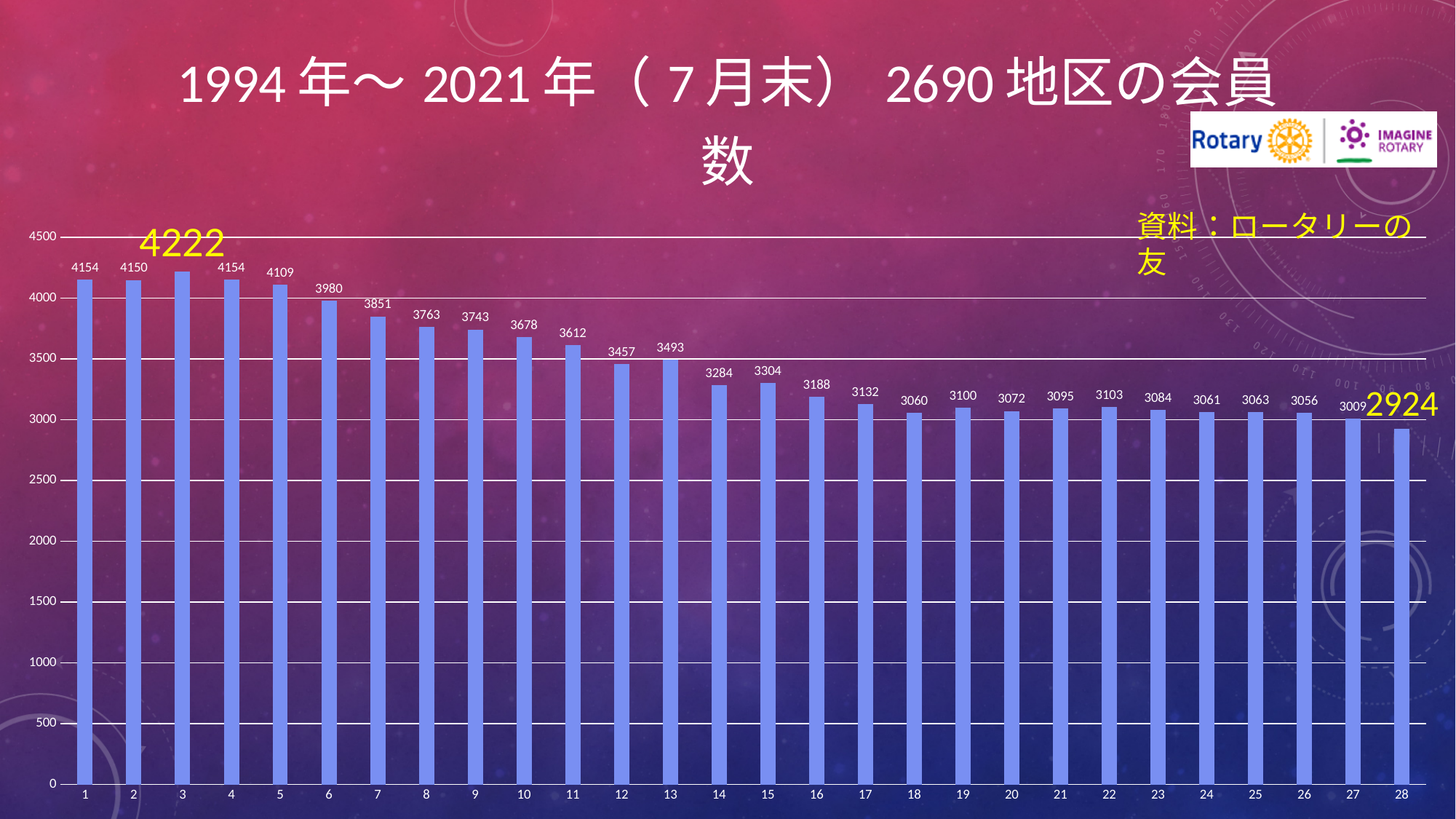
What is the difference between the values for category 3 and category 28? 1298 How many bars are shown in the chart? 28 What kind of chart is shown on the slide? bar chart Which category has the highest value? 3 What is the value for category 3? 4222 What is the value for category 28? 2924 What is the value for category 20? 3072 Which is larger, the value for category 6 or the value for category 12? category 6 Is the value for category 27 greater or less than 3000? greater Do the values generally rise or fall from category 1 to category 28? fall What is the value for category 13? 3493 Which category has the lowest value? 28